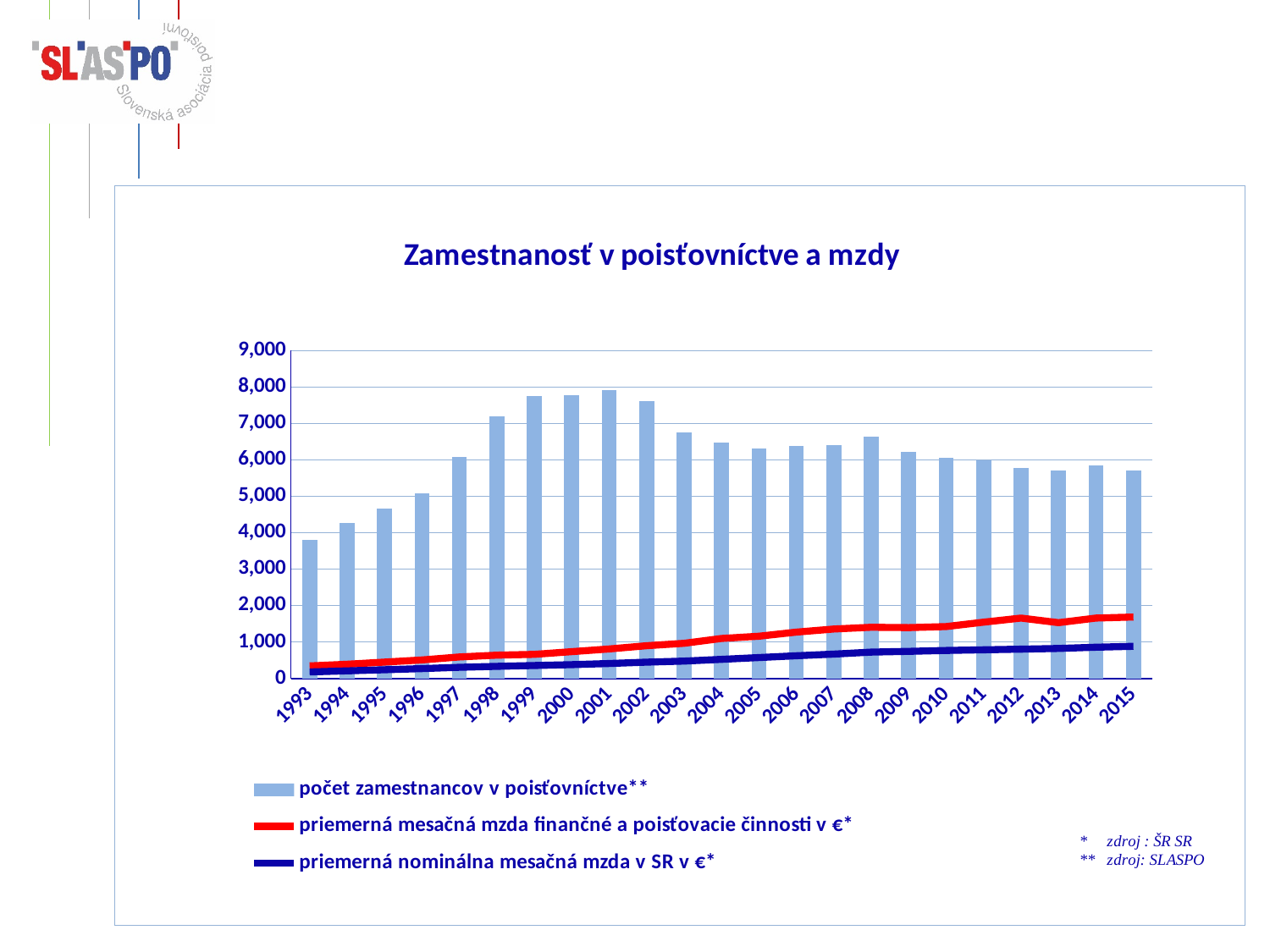
Which is larger, the bar for počet zamestnancov v poisťovníctve in 1994 or in 2015? 2015 What is the title of the chart? Zamestnanosť v poisťovníctve a mzdy How many years are shown on the x axis of the chart? 23 Is the bar for počet zamestnancov v poisťovníctve in 1998 greater or less than 7,000? greater How many series does the chart legend list? 3 Is the bar for počet zamestnancov v poisťovníctve in 2001 greater or less than 7,000? greater Which year has the lowest bar for počet zamestnancov v poisťovníctve? 1993 Is the bar for počet zamestnancov v poisťovníctve in 2015 greater or less than 5,000? greater Which series is shown by the light blue bars? počet zamestnancov v poisťovníctve Which line is higher throughout the chart, the red line or the dark blue line? the red line Do the bars for počet zamestnancov v poisťovníctve rise or fall from 1993 to 2001? rise